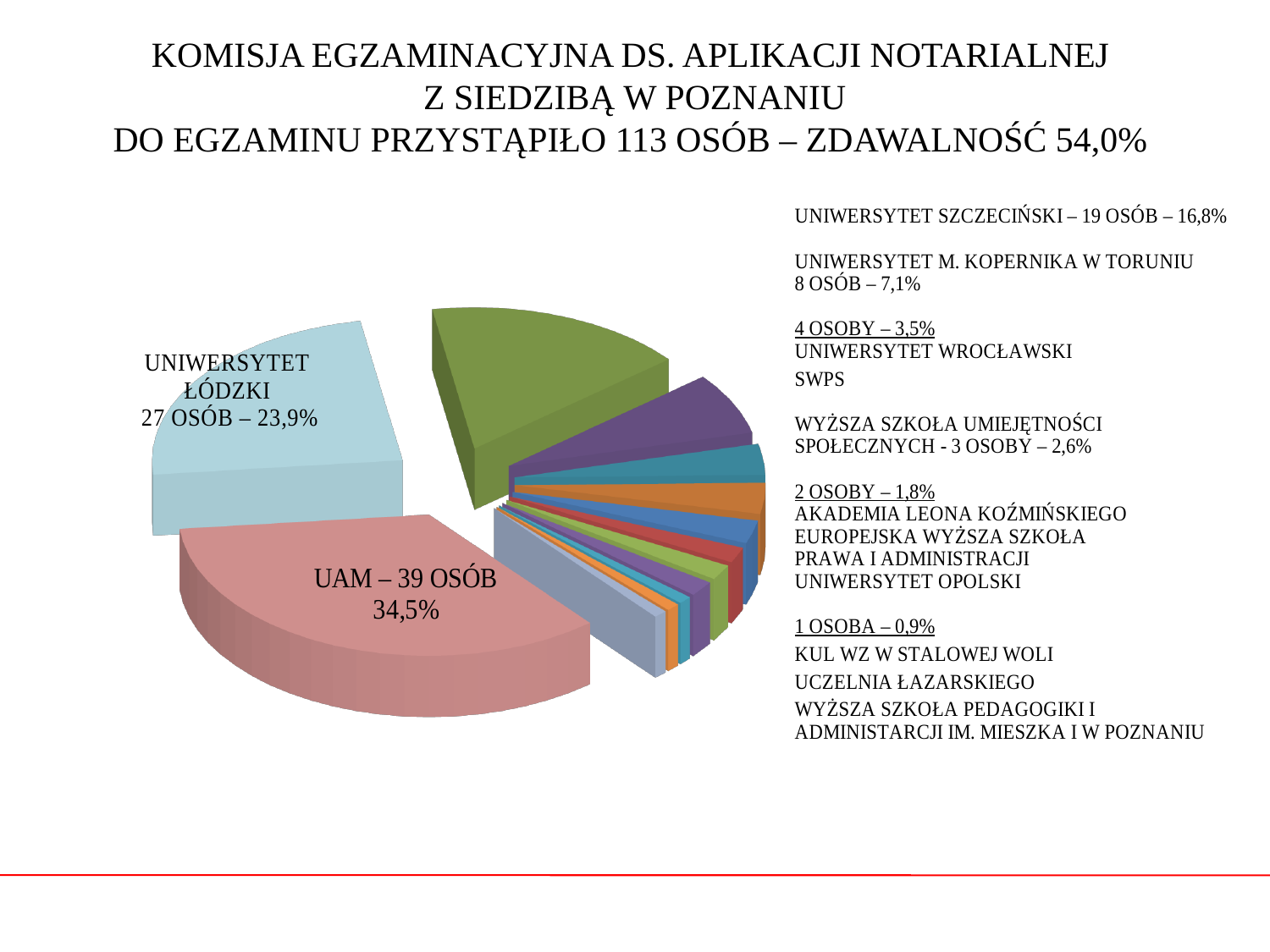
How many people from UAM took the exam according to the pie chart? 39 OSÓB Which is larger: the slice for UNIWERSYTET ŁÓDZKI or the slice for UNIWERSYTET SZCZECIŃSKI? UNIWERSYTET ŁÓDZKI What percentage share is given for UNIWERSYTET M. KOPERNIKA W TORUNIU? 7,1% What is the share of the pie for UAM? 34,5% What kind of chart is shown on the slide? Pie chart How many people from UNIWERSYTET SZCZECIŃSKI took the exam? 19 OSÓB What pass rate (zdawalność) is stated in the slide title? 54,0% According to the slide title, how many people took the exam in total? 113 Which institution has the largest slice of the pie chart? UAM What is the smallest percentage share listed for any institution on the slide? 0,9% How many more people came from UAM than from UNIWERSYTET ŁÓDZKI? 12 What percentage share does UNIWERSYTET ŁÓDZKI have in the pie chart? 23,9%